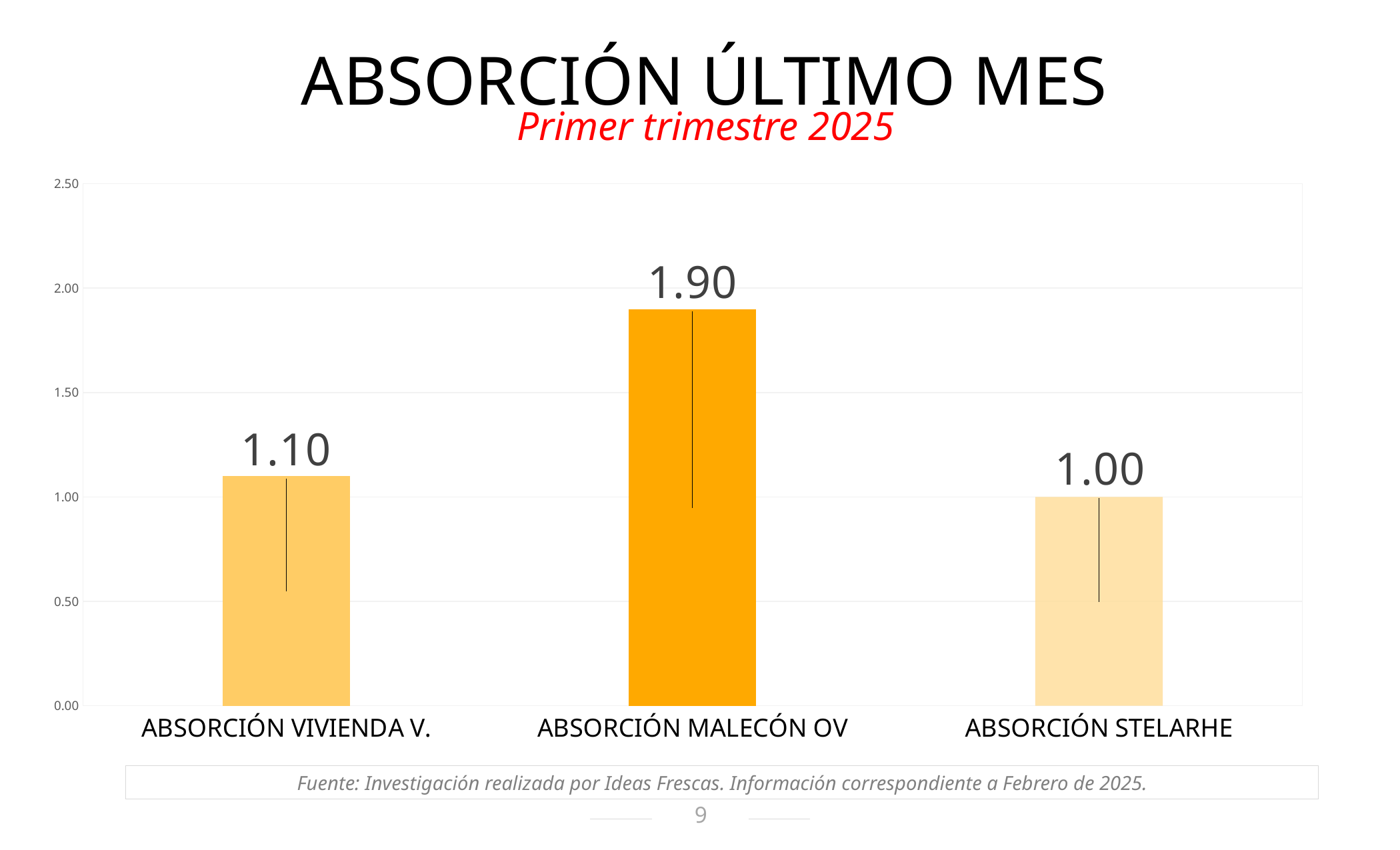
What is the difference between the values for ABSORCIÓN MALECÓN OV and ABSORCIÓN VIVIENDA V.? 0.80 What is the value for ABSORCIÓN MALECÓN OV? 1.90 Which category has the highest value? ABSORCIÓN MALECÓN OV What is the title of the chart? ABSORCIÓN ÚLTIMO MES Which is larger, the value for ABSORCIÓN MALECÓN OV or the value for ABSORCIÓN STELARHE? ABSORCIÓN MALECÓN OV Which category has the lowest value? ABSORCIÓN STELARHE How many categories are shown in the chart? 3 Is the value for ABSORCIÓN MALECÓN OV greater or less than 1.50? greater What is the value for ABSORCIÓN VIVIENDA V.? 1.10 What is the difference between the values for ABSORCIÓN VIVIENDA V. and ABSORCIÓN STELARHE? 0.10 What kind of chart is shown on the slide? bar chart What is the value for ABSORCIÓN STELARHE? 1.00